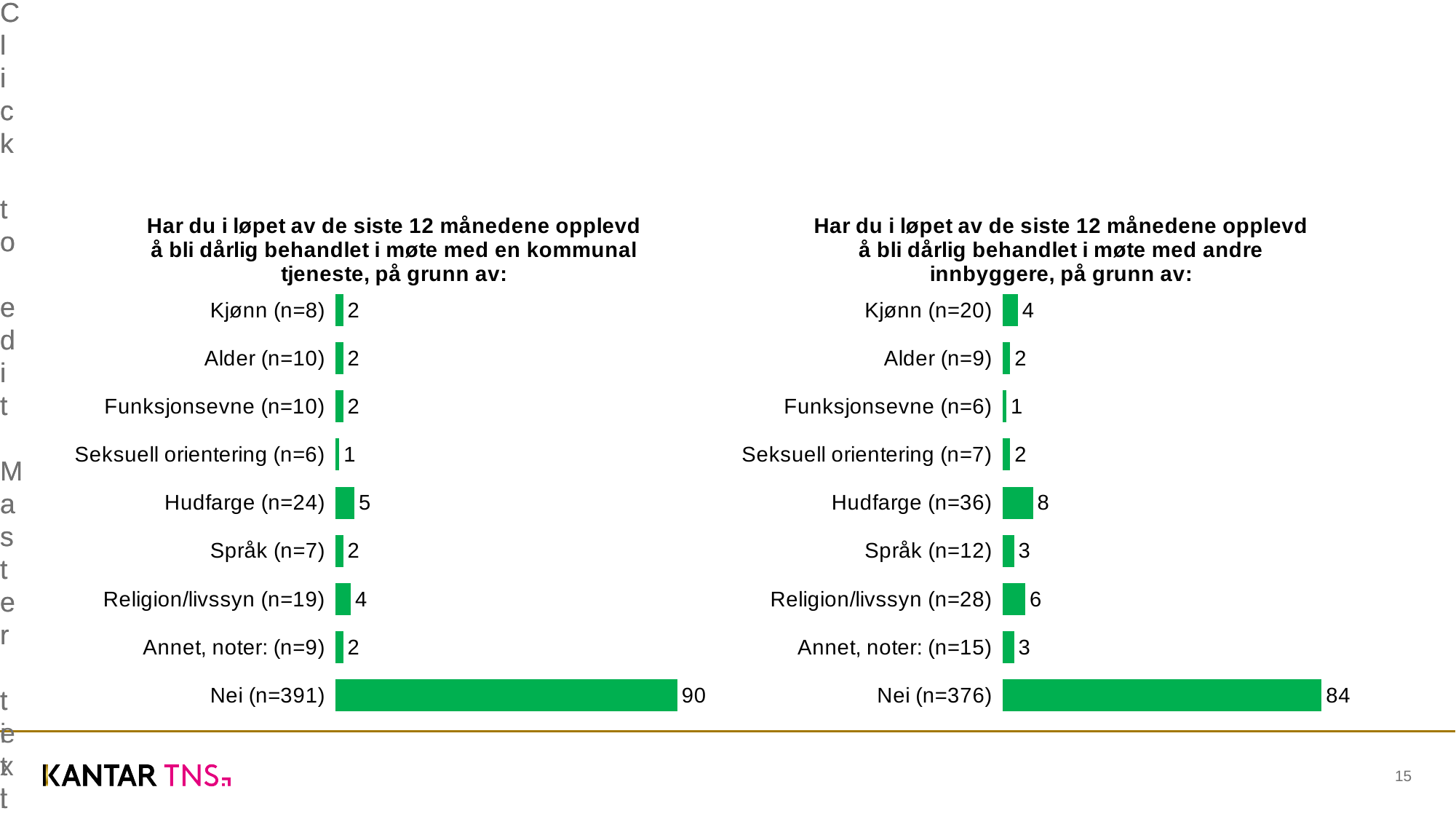
What kind of chart is the right chart (andre innbyggere)? Bar chart What colour are the bars in both charts? Green In the left chart (kommunal tjeneste), what is the value for Hudfarge (n=24)? 5 In the right chart (andre innbyggere), what is the value for Religion/livssyn (n=28)? 6 In the right chart (andre innbyggere), what is the difference between the values for Nei (n=376) and Hudfarge (n=36)? 76 In the right chart (andre innbyggere), which is larger: the value for Kjønn (n=20) or the value for Språk (n=12)? Kjønn (n=20) In the left chart (kommunal tjeneste), what is the difference between the values for Nei (n=391) and Hudfarge (n=24)? 85 In the right chart (andre innbyggere), which category has the lowest value? Funksjonsevne (n=6) In the left chart (kommunal tjeneste), what is the value for Seksuell orientering (n=6)? 1 How many categories does the left chart (kommunal tjeneste) show? 9 In the right chart (andre innbyggere), what is the value for Nei (n=376)? 84 In the left chart (kommunal tjeneste), which category has the highest value? Nei (n=391)